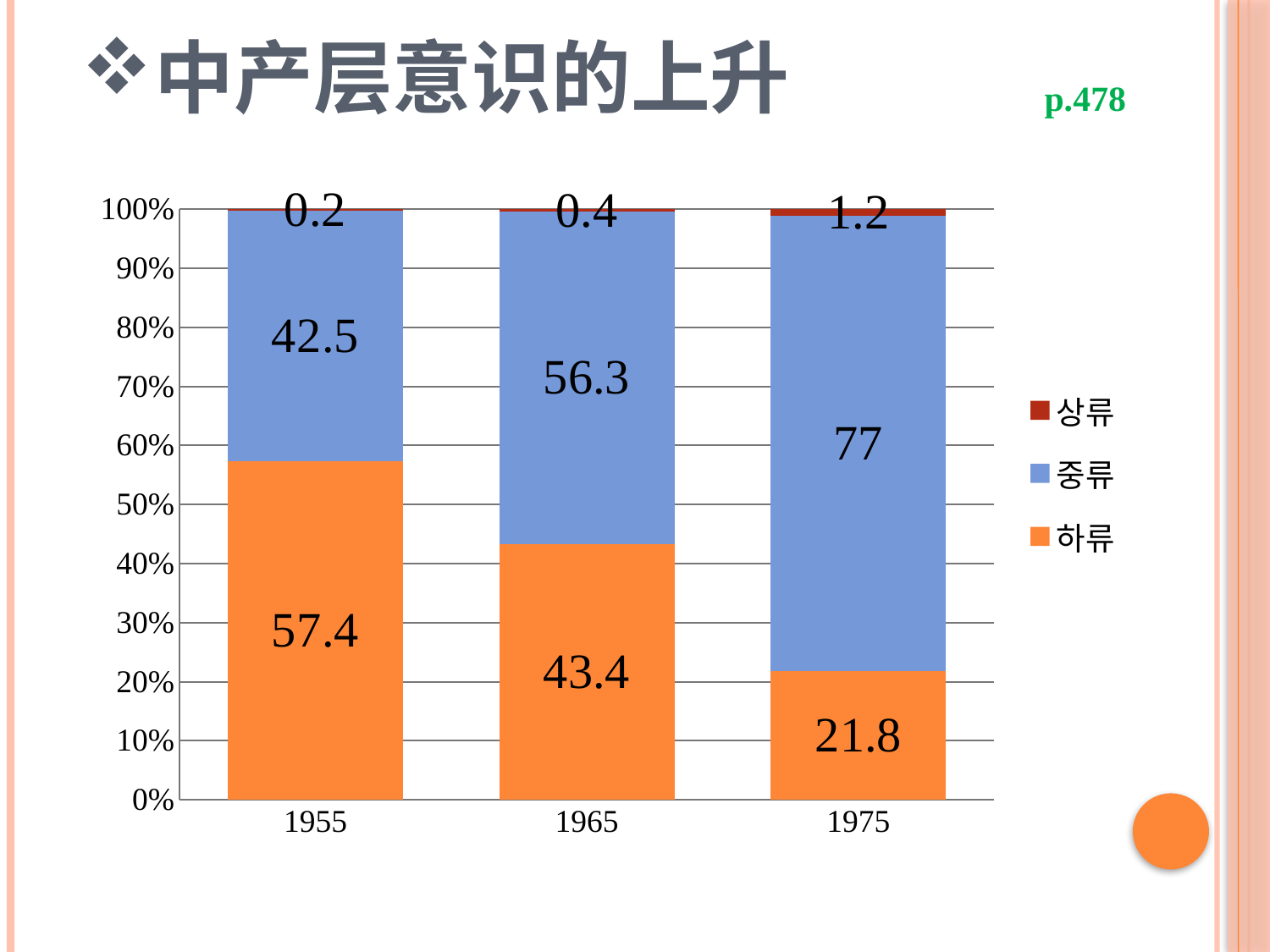
In which year is the 중류 value highest? 1975 Which is larger in 1965, the 중류 value or the 하류 value? 중류 Does the 하류 value rise or fall from 1955 to 1975? Fall What is the value for 중류 in 1965? 56.3 How many series does the legend list? 3 What is the value for 중류 in 1975? 77 What is the value for 상류 in 1965? 0.4 How many years are shown on the x axis? 3 In which year is the 하류 value lowest? 1975 What is the difference between the 중류 values for 1975 and 1955? 34.5 What kind of chart is shown on the slide? Stacked bar chart What is the value for 하류 in 1955? 57.4